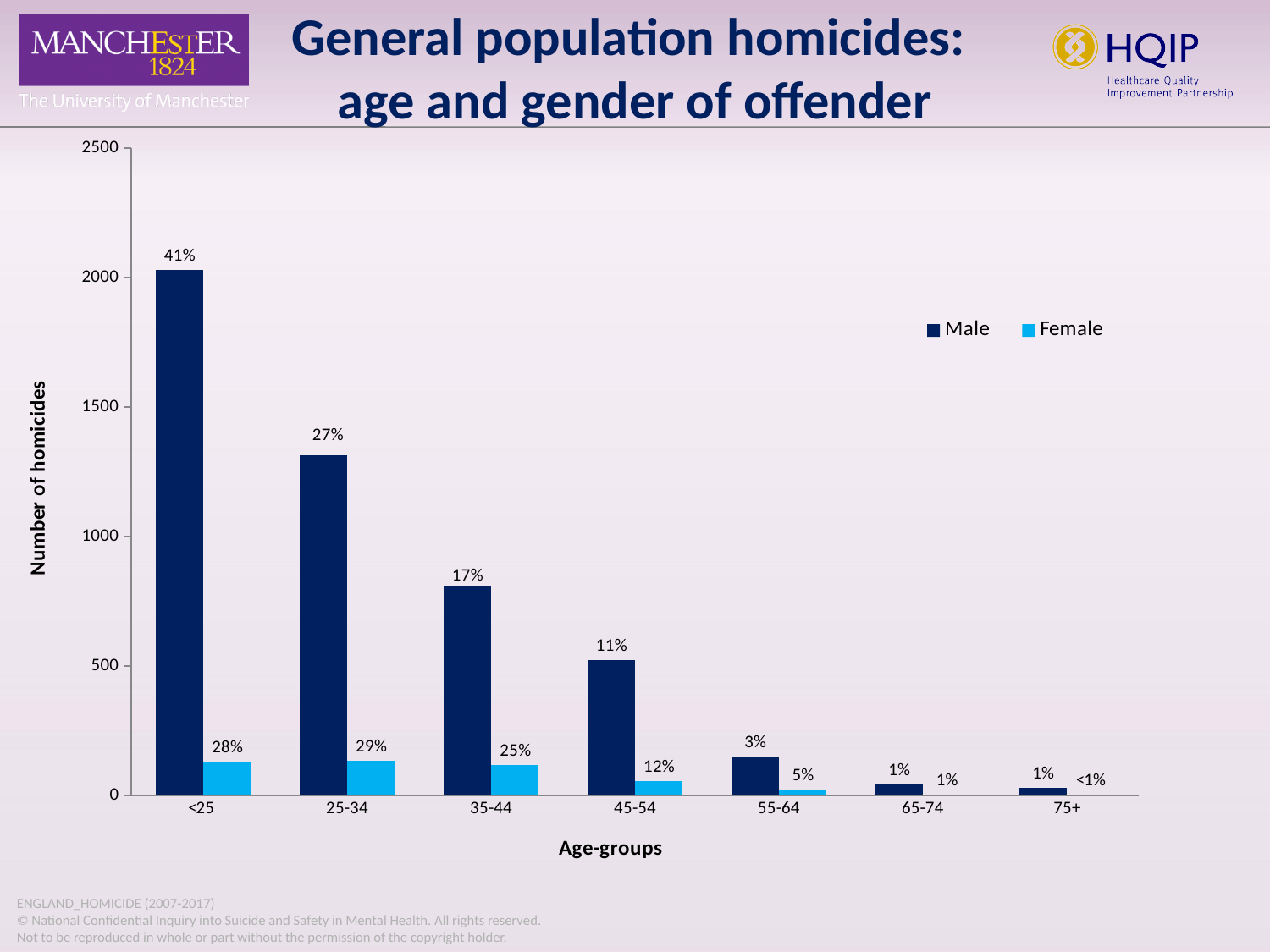
What type of chart is shown on the slide? Bar chart Which age group has the highest Male bar? <25 Which is larger for the 35-44 age group, the Male bar or the Female bar? Male Is the number of homicides for Male offenders aged <25 greater or less than 2000? greater What percentage label is shown on the Female bar for the 75+ age group? <1% Do the Male bars rise or fall as the age groups increase along the x axis? Fall What percentage label is shown on the Male bar for the <25 age group? 41% How many series does the legend list? 2 Is the number of homicides for Male offenders aged 25-34 greater or less than 1500? less What percentage label is shown on the Male bar for the 45-54 age group? 11% What percentage label is shown on the Female bar for the 25-34 age group? 29% How many age-group categories are shown on the x axis? 7